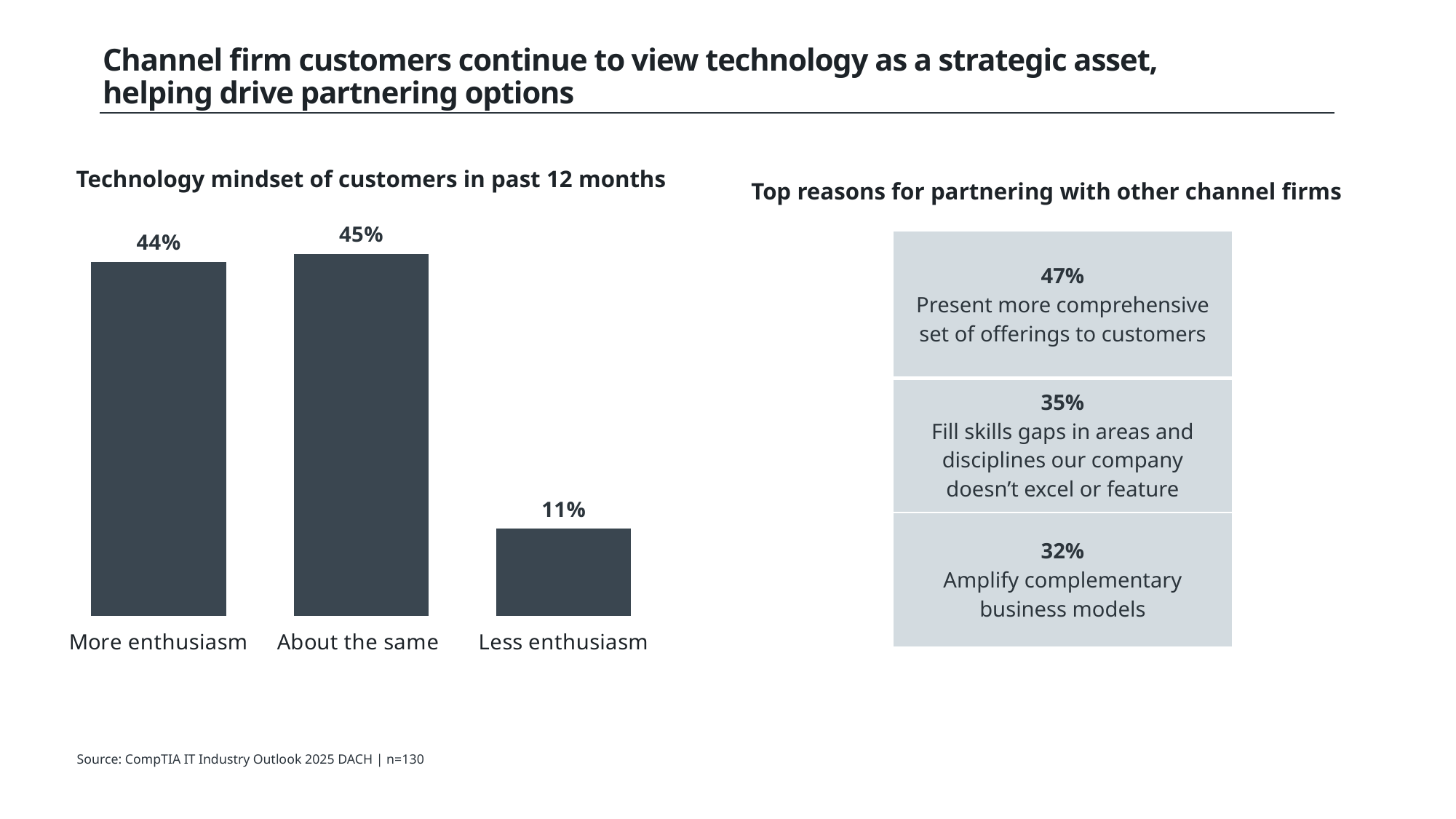
In the chart 'Technology mindset of customers in past 12 months', which category has the lowest value? Less enthusiasm In the chart 'Technology mindset of customers in past 12 months', which is larger: 'More enthusiasm' or 'Less enthusiasm'? More enthusiasm In the chart 'Technology mindset of customers in past 12 months', what is the value for 'More enthusiasm'? 44% In the chart 'Technology mindset of customers in past 12 months', what is the difference between 'About the same' and 'More enthusiasm'? 1% What kind of chart is 'Technology mindset of customers in past 12 months'? Bar chart What is the title of the bar chart on the left of the slide? Technology mindset of customers in past 12 months In the chart 'Technology mindset of customers in past 12 months', which category has the highest value? About the same In the chart 'Technology mindset of customers in past 12 months', what is the value for 'Less enthusiasm'? 11% What colour are the bars in the chart 'Technology mindset of customers in past 12 months'? Dark grey In the chart 'Technology mindset of customers in past 12 months', what is the difference between 'More enthusiasm' and 'Less enthusiasm'? 33% How many categories are shown in the chart 'Technology mindset of customers in past 12 months'? 3 In the chart 'Technology mindset of customers in past 12 months', what is the value for 'About the same'? 45%